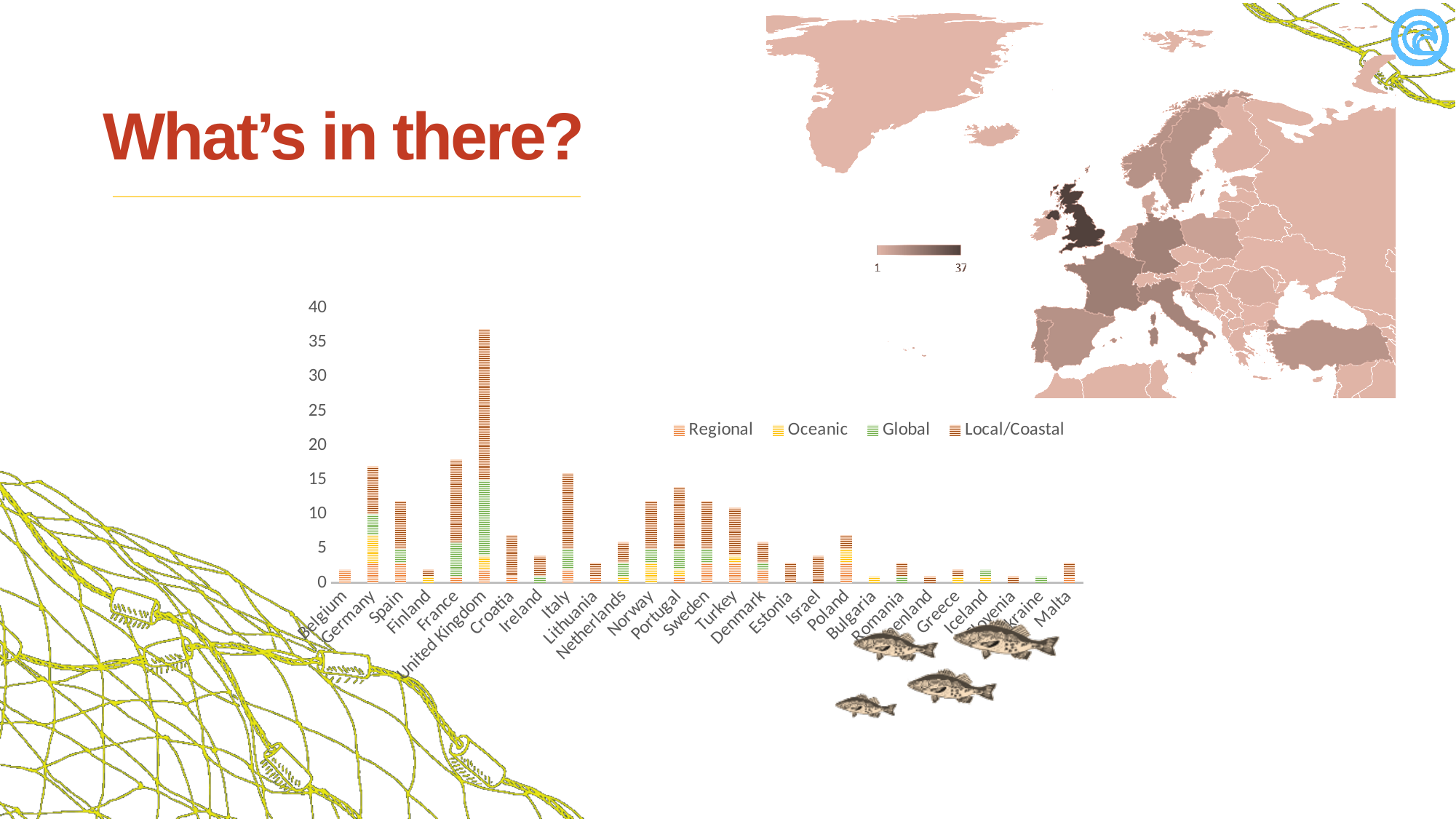
Is the total value for Spain greater or less than 15? less Which has the larger total bar, United Kingdom or Germany? United Kingdom Is the total value for Italy greater or less than 10? greater Is the total value for United Kingdom greater or less than 30? greater What are the four series named in the chart legend? Regional, Oceanic, Global, Local/Coastal Which has the larger total bar, France or Spain? France Which country has the highest total bar in the chart? United Kingdom How many series does the chart legend list? 4 What kind of chart is shown on the slide? bar chart